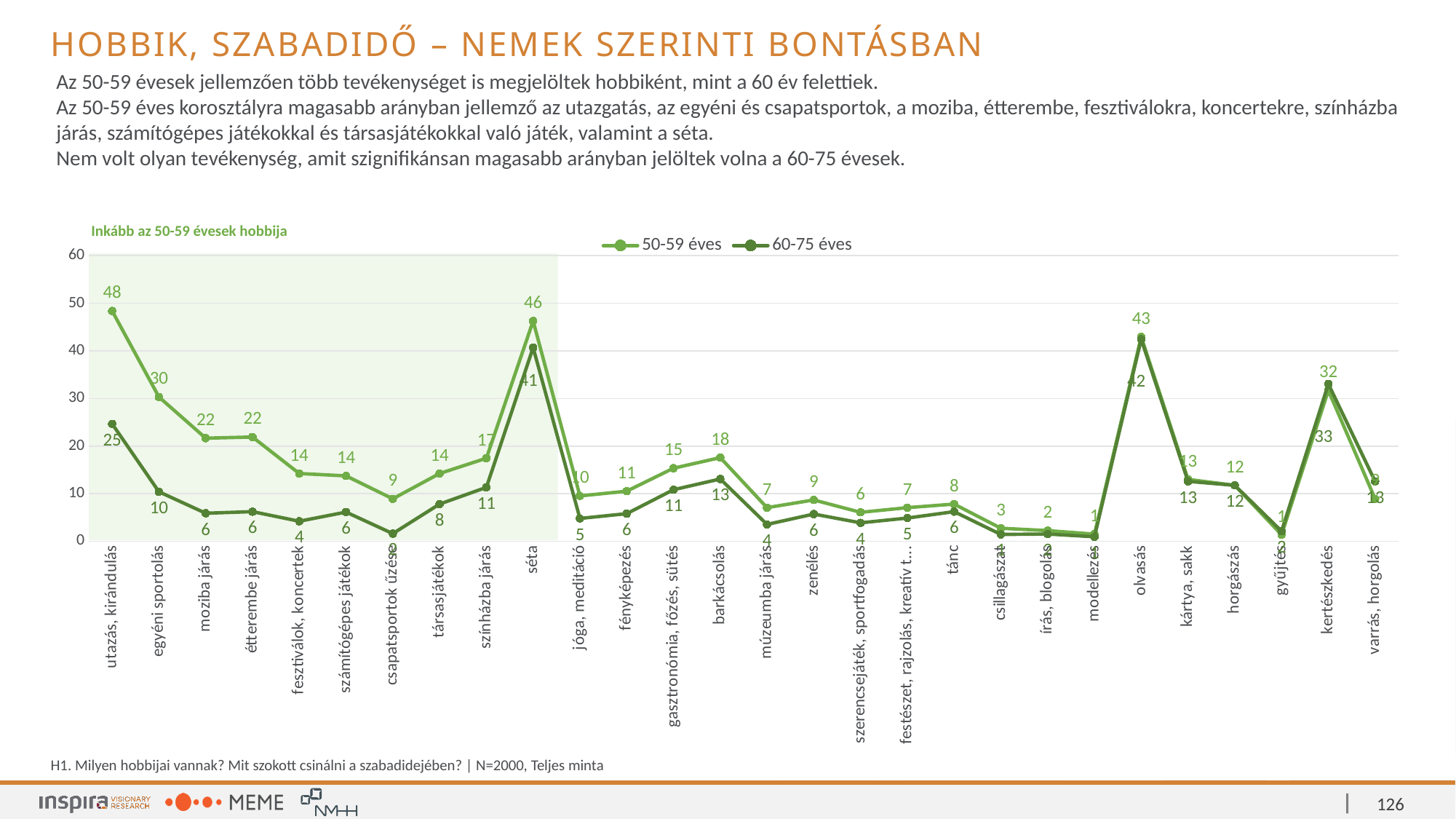
What are the two series named in the legend? 50-59 éves and 60-75 éves What is the value for 'barkácsolás' in the 60-75 éves series? 13 What is the value for 'olvasás' in the 50-59 éves series? 43 What kind of chart is shown on the slide? line chart Which category has the highest value in the 50-59 éves series? utazás, kirándulás How many categories are shown on the x axis? 28 What is the value for 'utazás, kirándulás' in the 50-59 éves series? 48 What is the difference between the 50-59 éves and 60-75 éves values for 'utazás, kirándulás'? 23 Which category has the highest value in the 60-75 éves series? olvasás What is the value for 'séta' in the 60-75 éves series? 41 For 'egyéni sportolás', which series has the larger value, 50-59 éves or 60-75 éves? 50-59 éves How many series does the legend list? 2